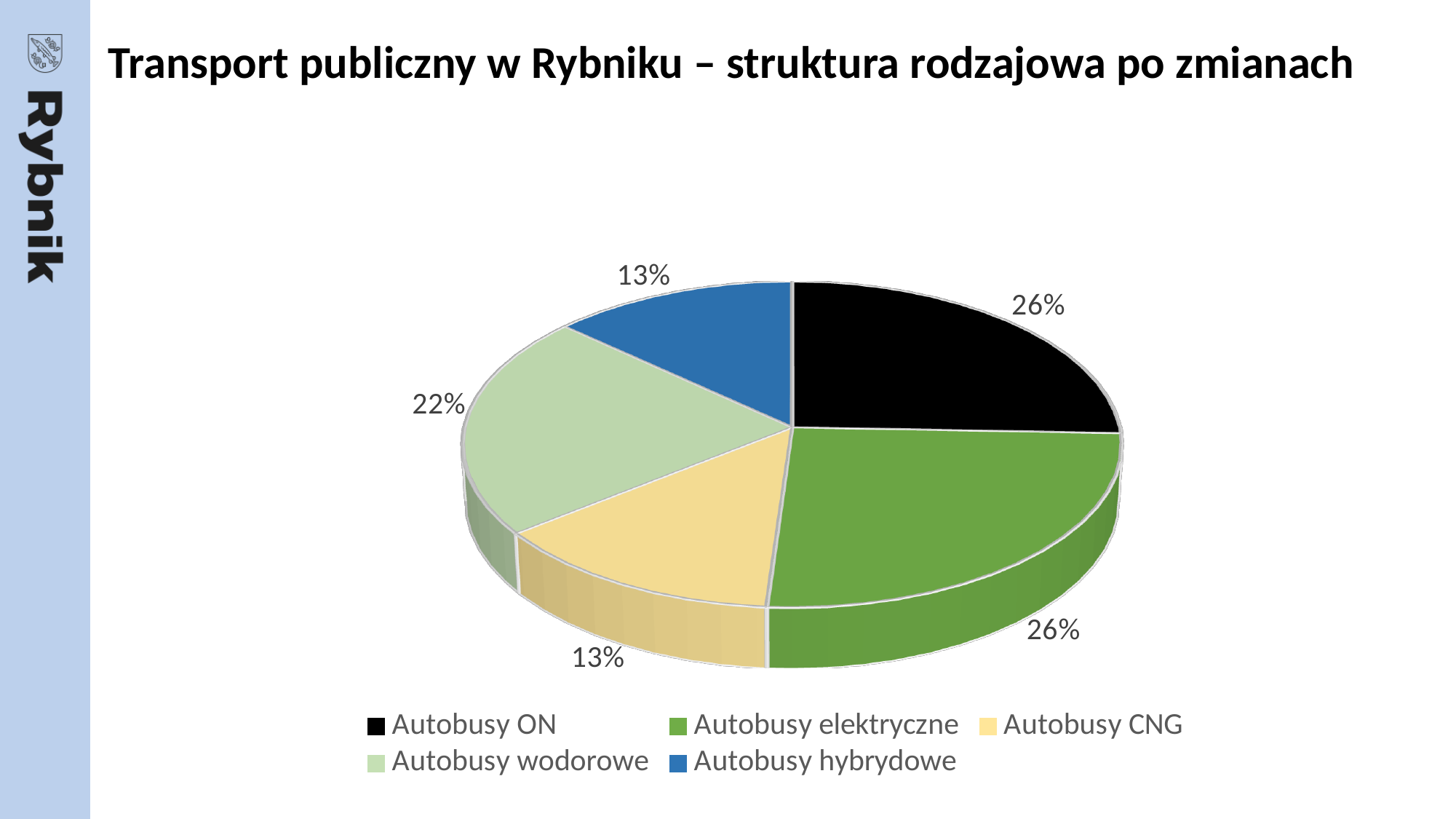
Which is larger, the share for Autobusy wodorowe or the share for Autobusy CNG? Autobusy wodorowe How many slices does the pie chart have? 5 What kind of chart is shown on the slide? Pie chart How many entries does the legend list? 5 Which colour represents Autobusy hybrydowe in the pie chart? Blue What percentage is shown for Autobusy hybrydowe? 13% What is the title of the chart on the slide? Transport publiczny w Rybniku – struktura rodzajowa po zmianach What is the difference in percentage points between Autobusy wodorowe and Autobusy hybrydowe? 9 percentage points What percentage is shown for Autobusy elektryczne? 26% What percentage is shown for Autobusy ON? 26% What share of the pie does Autobusy wodorowe represent? 22% What percentage is shown for Autobusy CNG? 13%